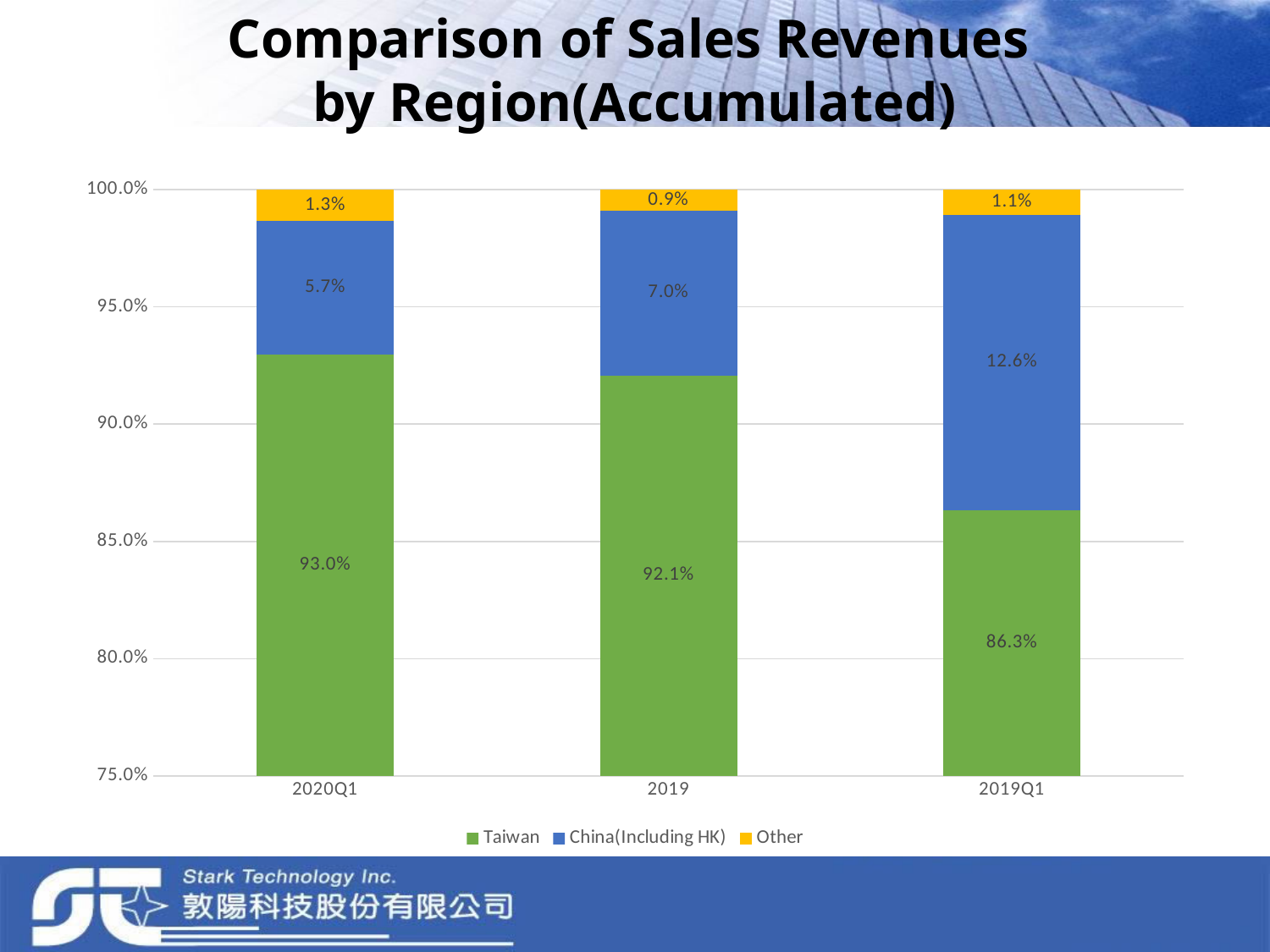
What kind of chart is shown on the slide? Stacked bar chart What is the China(Including HK) share of sales revenue for 2019Q1? 12.6% Which period has the lowest China(Including HK) share? 2020Q1 Which period has the highest Taiwan share? 2020Q1 Is the Taiwan share for 2019Q1 greater or less than 90.0%? less How many periods are shown on the x axis? 3 What is the Taiwan share of sales revenue for 2020Q1? 93.0% Is the China(Including HK) share larger in 2019 or in 2019Q1? 2019Q1 What is the difference between the Taiwan share in 2020Q1 and in 2019Q1? 6.7% Which colour represents Other in the chart? Yellow What is the Other share of sales revenue for 2019? 0.9% How many series does the legend list? 3